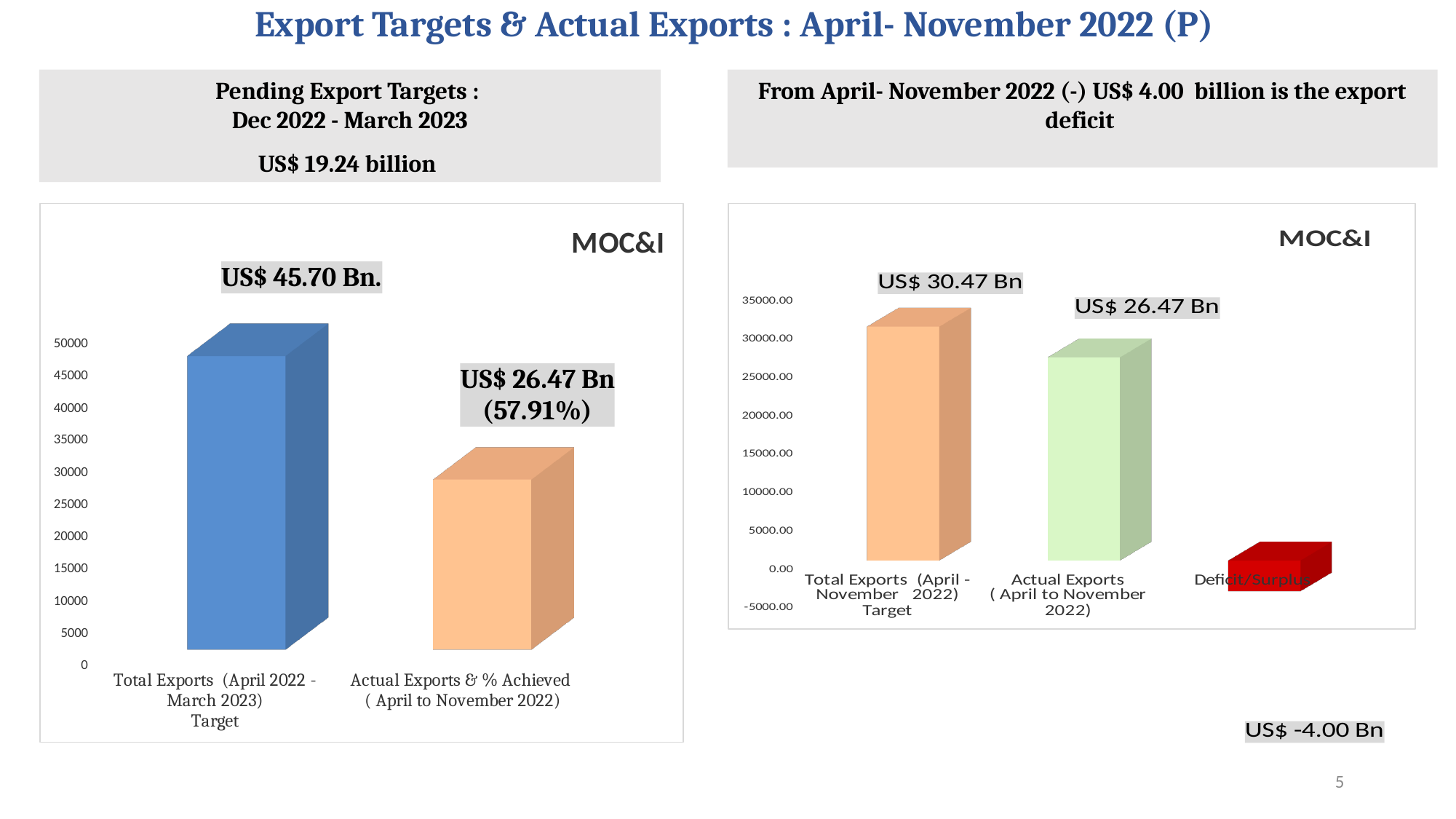
In the right chart, is the Total Exports Target larger or smaller than the Actual Exports? larger In the right chart, what is the value labelled for Deficit/Surplus? US$ -4.00 Bn In the right chart, which category has the lowest value? Deficit/Surplus In the left chart, what is the value labelled for Total Exports (April 2022 - March 2023) Target? US$ 45.70 Bn. What type of chart is the left chart? bar chart How many bars are plotted in the left chart? 2 How many categories are plotted in the right chart? 3 In the left chart, which category has the higher value? Total Exports (April 2022 - March 2023) Target In the left chart, what percentage achieved is shown for Actual Exports (April to November 2022)? 57.91% In the left chart, what is the value labelled for Actual Exports (April to November 2022)? US$ 26.47 Bn In the right chart, what is the value labelled for Total Exports (April - November 2022) Target? US$ 30.47 Bn In the right chart, what is the difference between the Total Exports Target and the Actual Exports? US$ 4.00 Bn